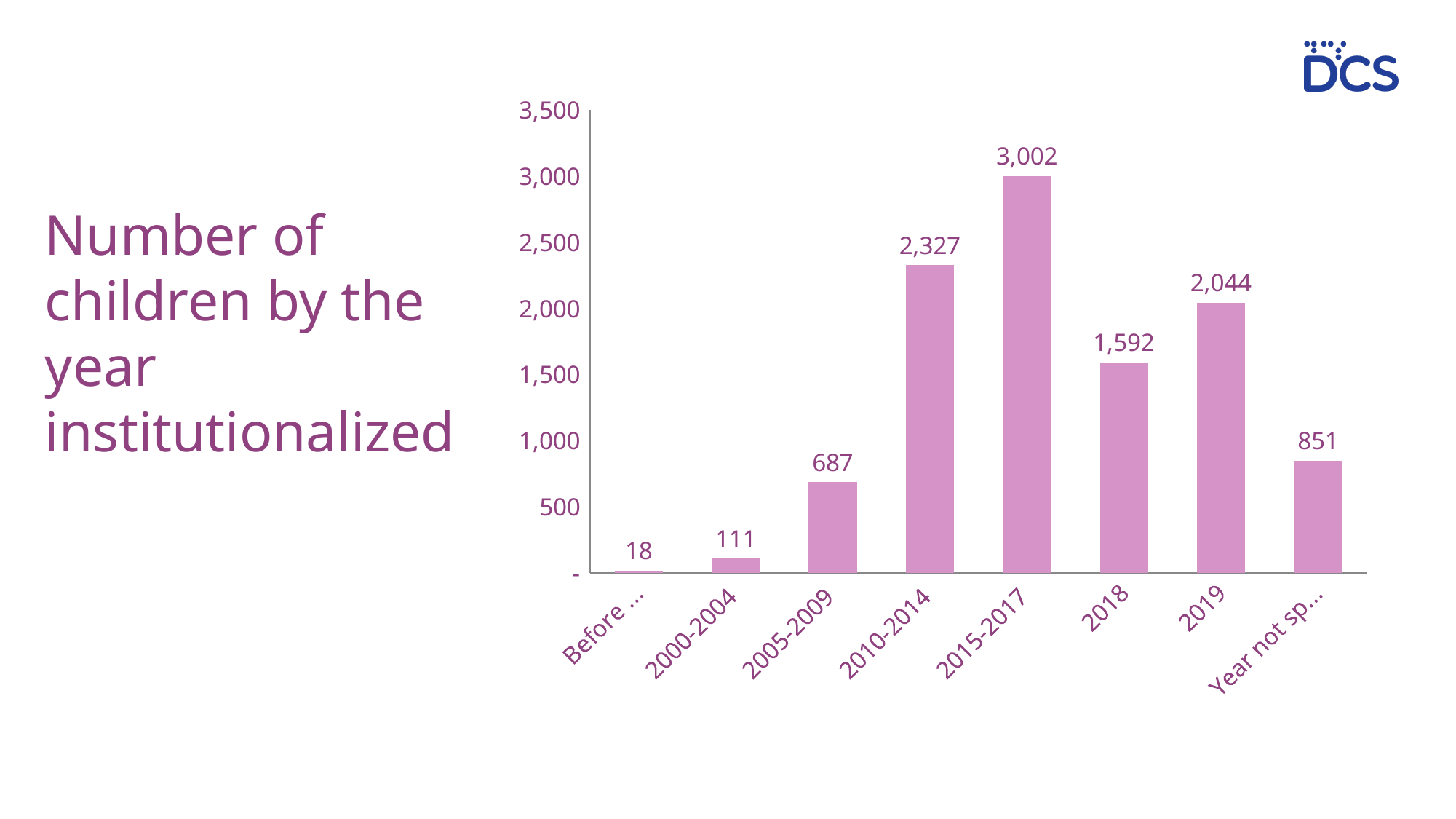
Which period has the highest number of children institutionalized? 2015-2017 Do the values rise or fall from 2000-2004 to 2015-2017? Rise What is the difference between the values for 2019 and 2018? 452 How many bars are shown in the chart? 8 Which is larger, the value for 2010-2014 or the value for 2019? 2010-2014 Which of the labelled periods has the lowest value, 2000-2004 or 2005-2009? 2000-2004 What is the number of children institutionalized in 2005-2009? 687 What is the number of children institutionalized in 2015-2017? 3,002 What is the number of children institutionalized in 2019? 2,044 What kind of chart is shown on the slide? Bar chart What is the difference between the values for 2015-2017 and 2018? 1,410 What is the number of children institutionalized in 2010-2014? 2,327